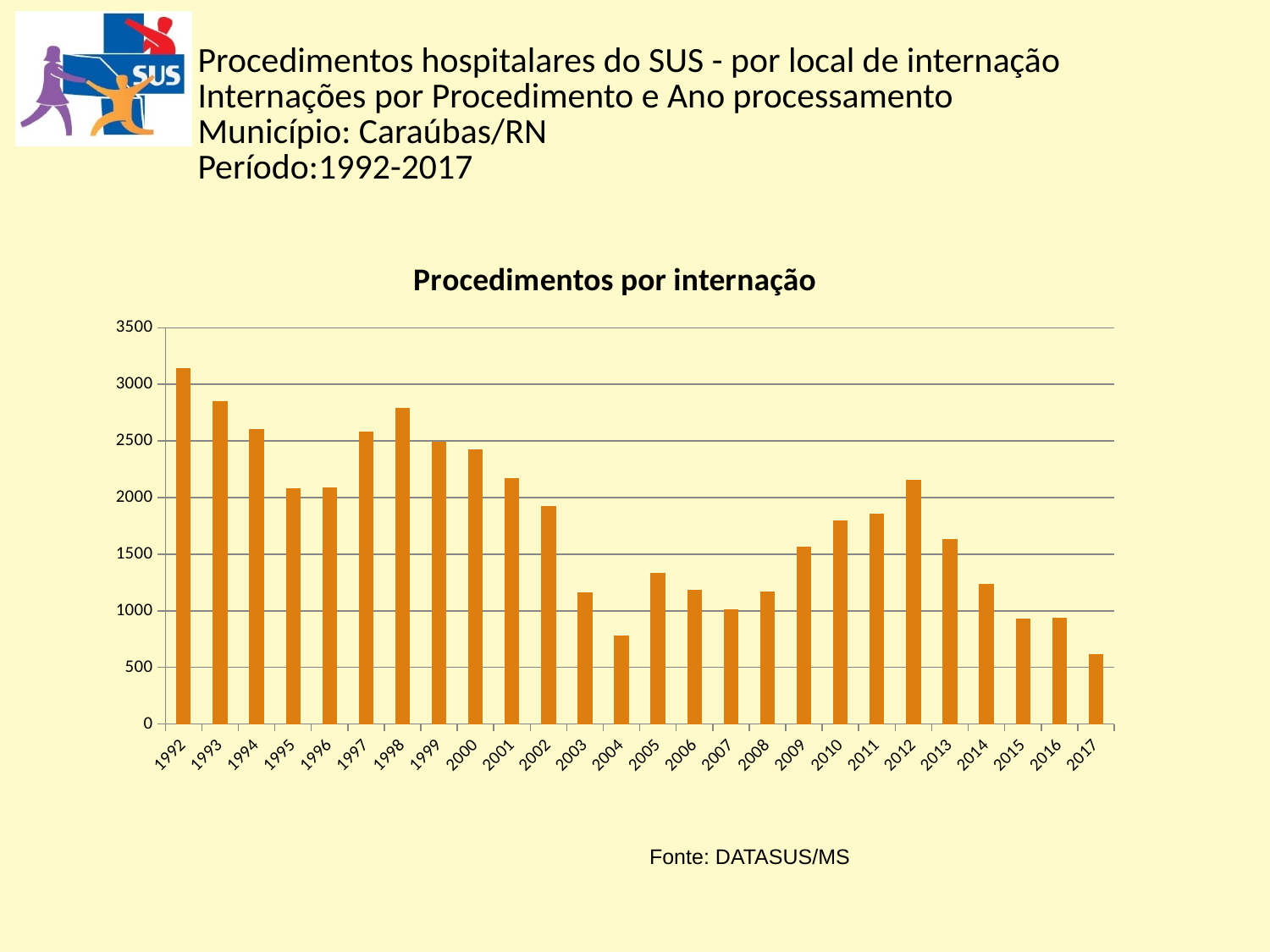
Which is larger, the value for 2004 or the value for 2017? 2004 Overall, do the values rise or fall from 1992 to 2017? fall Is the value for 1998 greater or less than 2500? greater Is the value for 2012 greater or less than 2000? greater Which year has the highest value in the chart? 1992 Is the value for 1992 greater or less than 3000? greater Which is larger, the value for 1992 or the value for 1993? 1992 How many years are plotted on the x axis of the chart? 26 Which year has the lowest value in the chart? 2017 What is the title of the chart? Procedimentos por internação What kind of chart is shown on the slide? bar chart